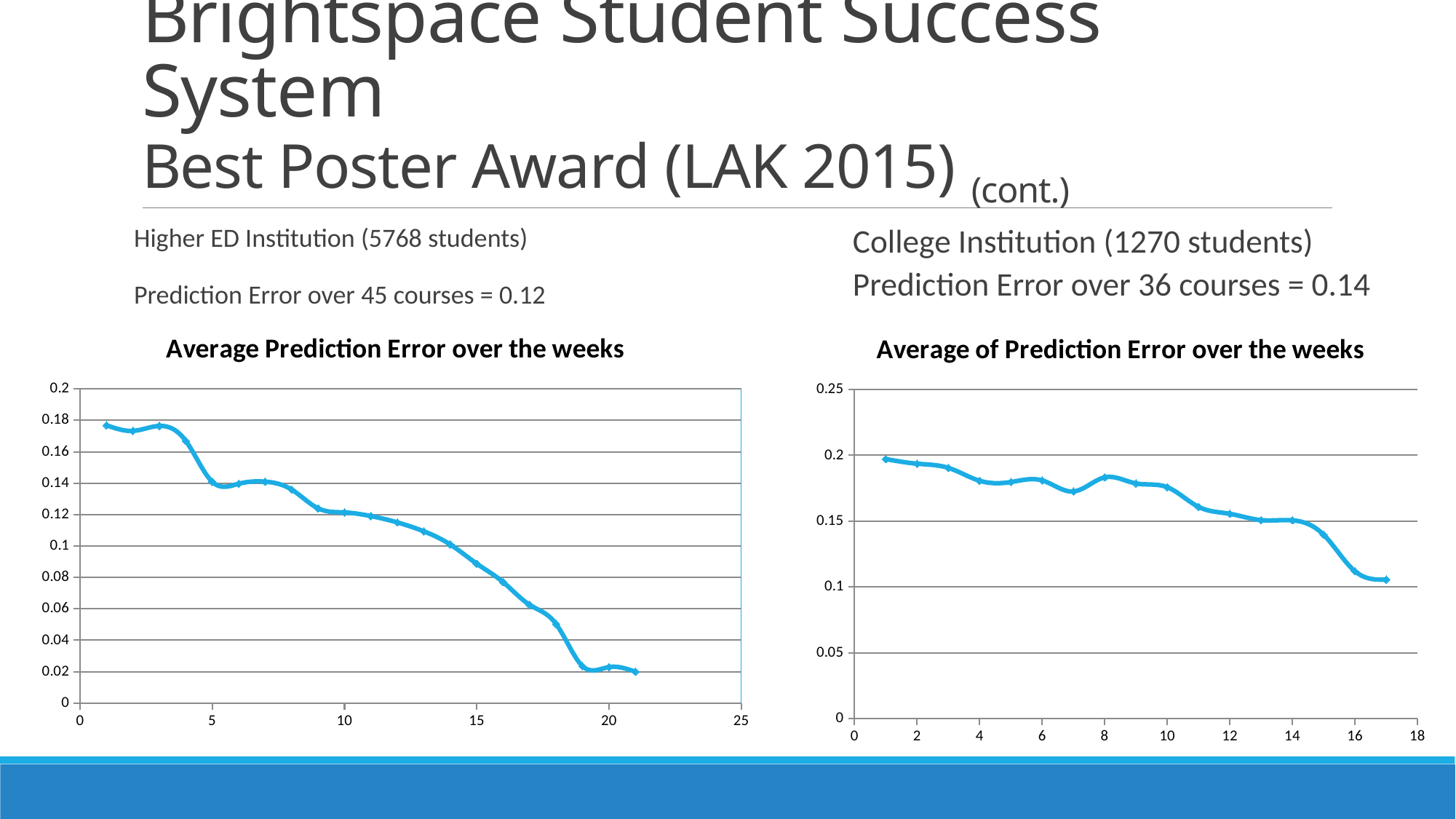
What kind of chart is the right chart titled 'Average of Prediction Error over the weeks'? line chart In the left chart 'Average Prediction Error over the weeks', do the values rise or fall as the weeks increase? fall In the right chart 'Average of Prediction Error over the weeks', do the values rise or fall as the weeks increase? fall In the right chart 'Average of Prediction Error over the weeks', is the value at week 17 greater or less than 0.15? less In the left chart 'Average Prediction Error over the weeks', is the value at week 21 greater or less than 0.04? less In the right chart 'Average of Prediction Error over the weeks', which week has the highest value? 1 In the right chart 'Average of Prediction Error over the weeks', is the value at week 4 greater or less than 0.15? greater What kind of chart is the left chart titled 'Average Prediction Error over the weeks'? line chart In the right chart 'Average of Prediction Error over the weeks', which week has the lowest value? 17 What is the title of the left chart? Average Prediction Error over the weeks